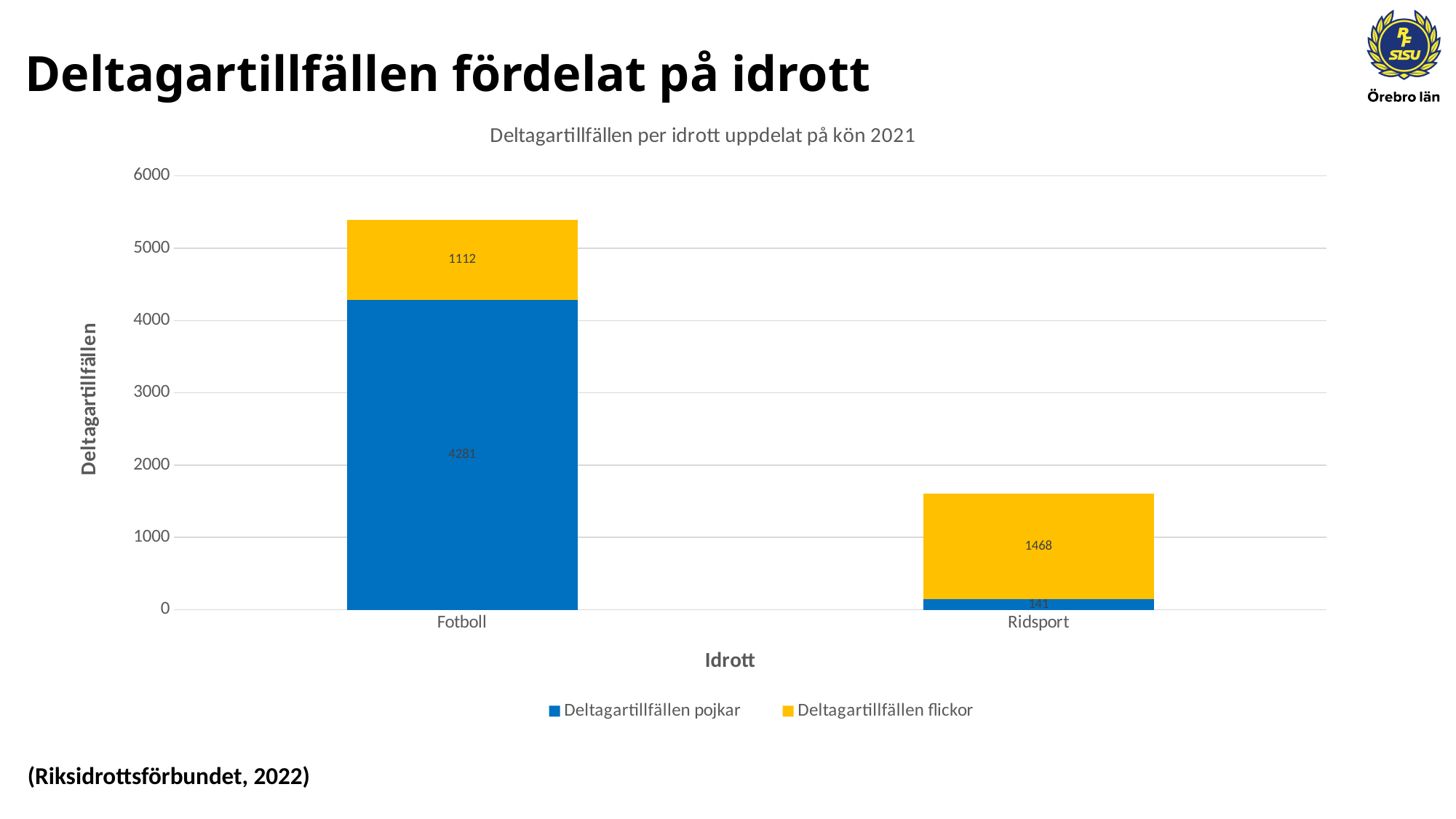
How many series does the legend list? 2 Which category has the lowest value for Deltagartillfällen flickor? Fotboll What kind of chart is shown on the slide? Stacked bar chart Which is larger for Ridsport: Deltagartillfällen pojkar or Deltagartillfällen flickor? Deltagartillfällen flickor What is the value for Deltagartillfällen flickor for Fotboll? 1112 What is the difference between Deltagartillfällen pojkar and Deltagartillfällen flickor for Fotboll? 3169 What is the value for Deltagartillfällen pojkar for Fotboll? 4281 What is the total of the stacked bar for Ridsport? 1609 What is the total of the stacked bar for Fotboll? 5393 Which category has the highest value for Deltagartillfällen pojkar? Fotboll What is the value for Deltagartillfällen flickor for Ridsport? 1468 What is the value for Deltagartillfällen pojkar for Ridsport? 141